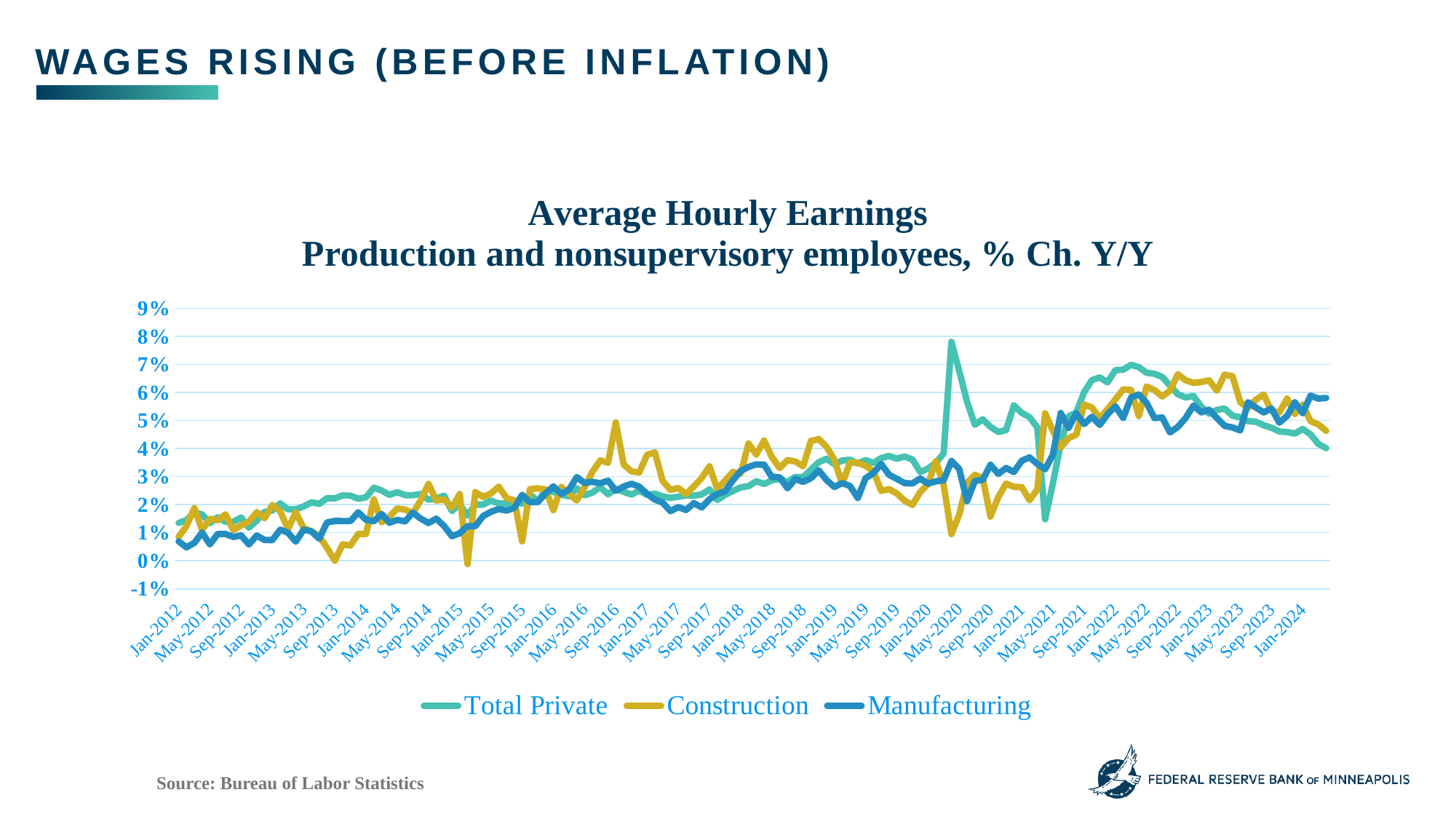
How many series does the legend list? 3 What kind of chart is shown on the slide? Line chart At Jan-2024, which is larger: Manufacturing or Total Private? Manufacturing Overall, does the Total Private series rise or fall from Jan-2012 to Jan-2024? rise Is the value for Total Private at Jan-2024 greater or less than 5%? less Which series reaches the highest value anywhere on the chart? Total Private Is the value for Construction around Sep-2013 greater or less than 1%? less What are the three series named in the legend? Total Private, Construction, Manufacturing Which series dips to the lowest value anywhere on the chart? Construction What is the first line of the chart's title? Average Hourly Earnings Is the value for Manufacturing at Jan-2012 greater or less than 1%? less